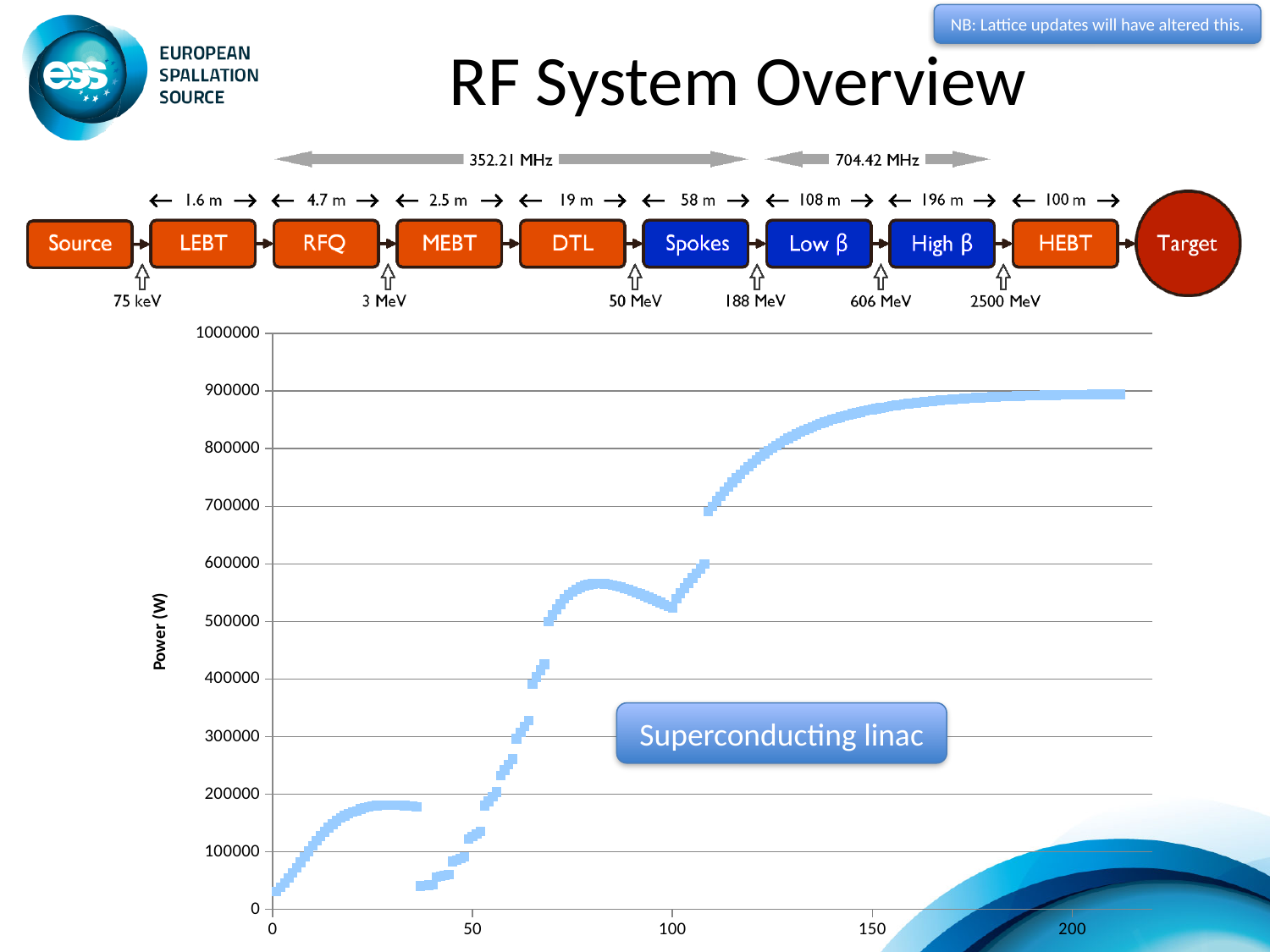
Is the plotted power value at x = 0 greater or less than 100000? less How many tick labels are shown on the horizontal axis of the chart? 5 What kind of chart is shown on the slide? scatter chart Is the plotted power value at x = 100 greater or less than 400000? greater Is the plotted power value at x = 50 greater or less than 200000? less What is the highest tick value shown on the vertical axis of the chart? 1000000 Which is larger, the plotted power value at x = 50 or at x = 150? x = 150 What is the label of the vertical axis of the chart? Power (W) What is the largest tick value shown on the horizontal axis of the chart? 200 Overall, do the plotted power values rise or fall as x increases from 0 to 200? rise